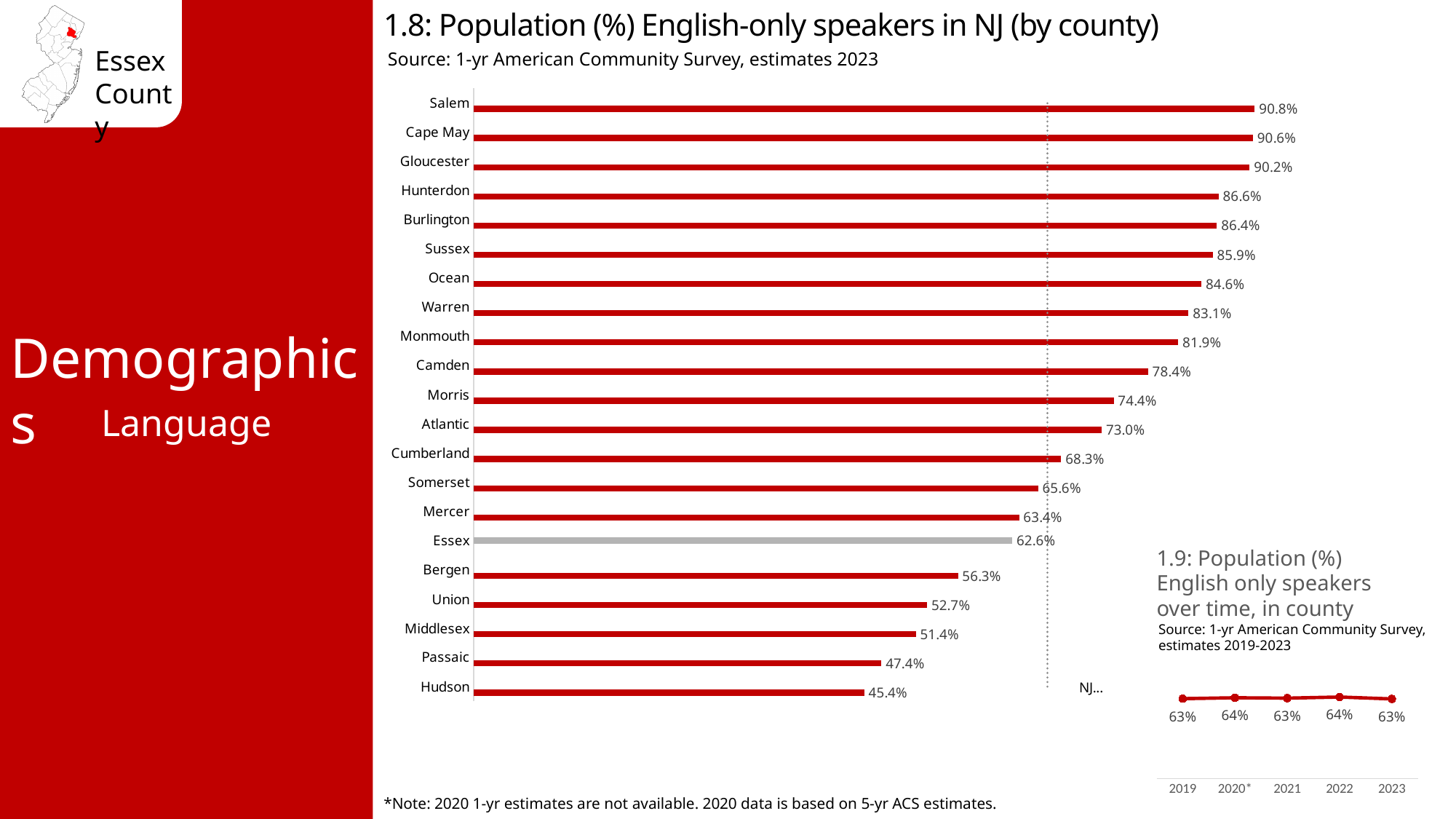
What kind of chart is chart 1.8? Bar chart In chart 1.8, what is the difference between the values for Salem and Hudson? 45.4% In chart 1.8, which county has the lowest percentage of English-only speakers? Hudson In chart 1.8, what is the difference between the values for Mercer and Essex? 0.8% In chart 1.8, which county has the highest percentage of English-only speakers? Salem In chart 1.8, what is the value for Hunterdon? 86.6% In chart 1.9, what is the value for 2022? 64% In chart 1.8, which bar is shown in a different colour (grey) from the others? Essex In chart 1.8, how many counties are plotted? 21 In chart 1.8, which has a higher value, Bergen or Union? Bergen In chart 1.9, how many data points are plotted? 5 In chart 1.8, what is the value for Essex? 62.6%